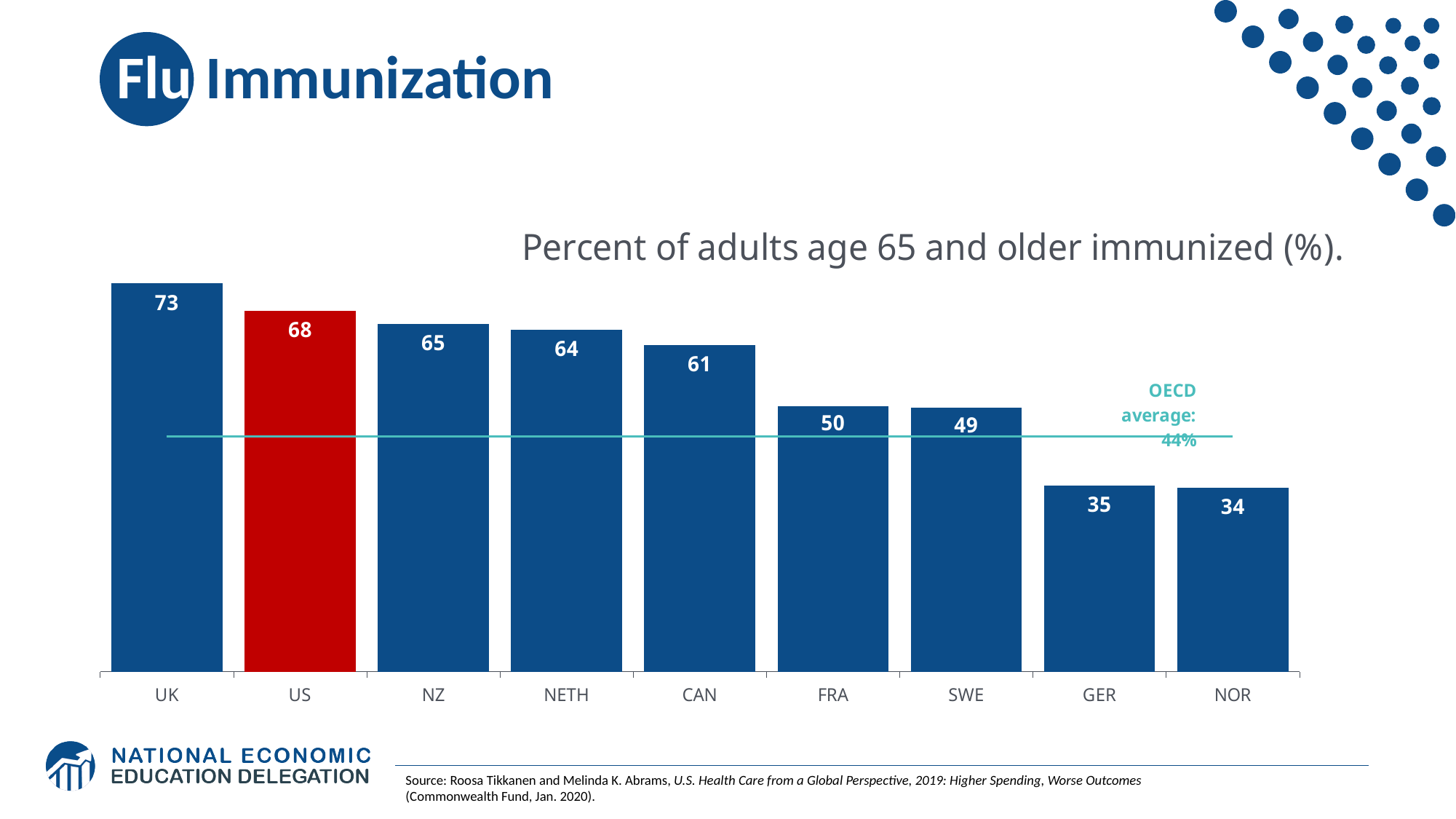
What is the difference between the values for the UK and the US? 5 What kind of chart is shown on the slide? Bar chart Which country has the highest value? UK What is the value for NETH? 64 What OECD average value is marked by the horizontal line on the chart? 44% Which is larger, the value for NZ or the value for SWE? NZ Which country has the lowest value? NOR How many countries are shown on the chart? 9 What is the difference between the values for CAN and GER? 26 What is the value for FRA? 50 What is the value for the US? 68 Do the values rise or fall from left to right along the x axis? Fall